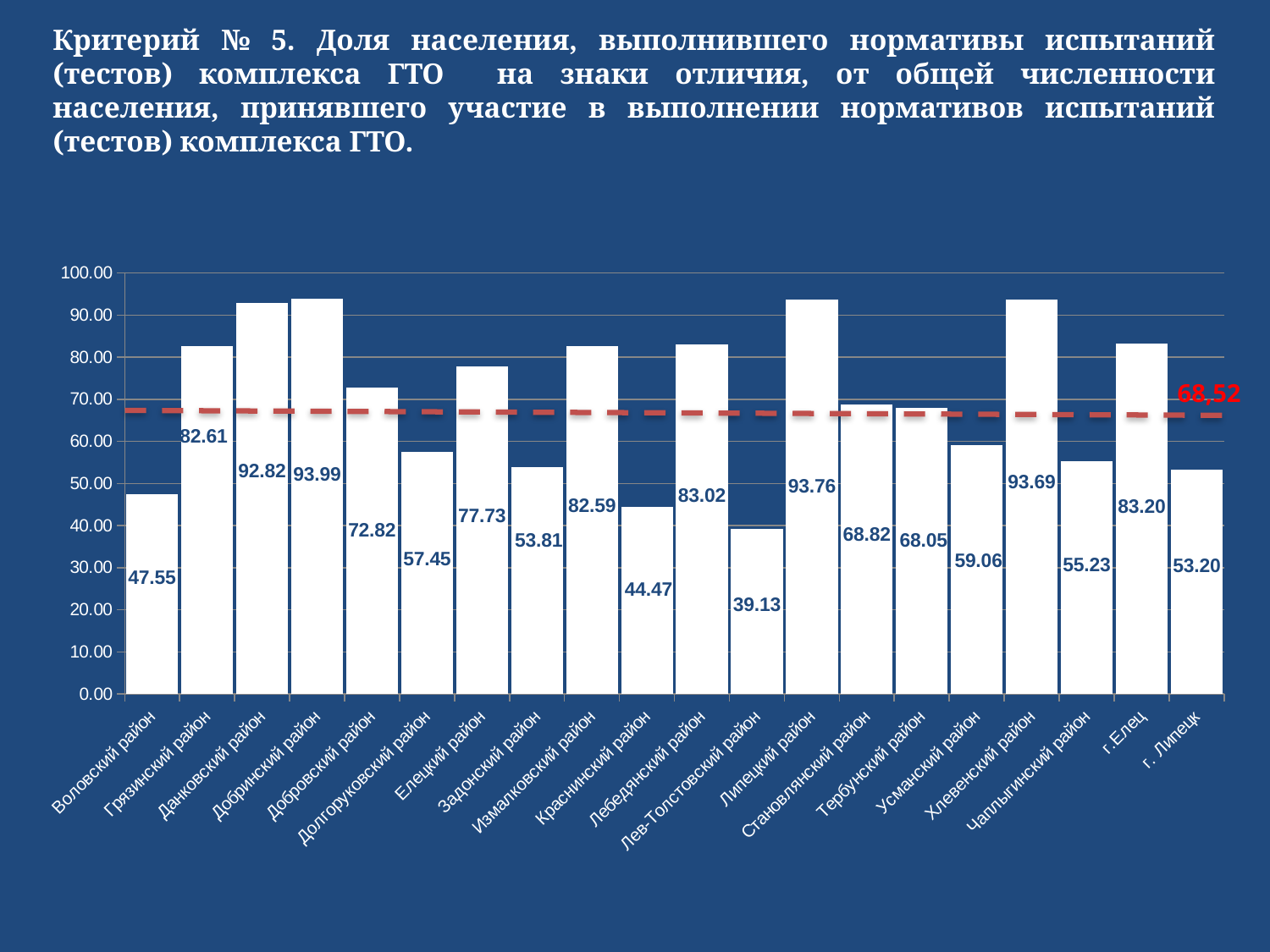
What kind of chart is shown on the slide? bar chart What is the value for Лев-Толстовский район? 39.13 Is the value for Краснинский район greater or less than 50.00? less What is the value for Хлевенский район? 93.69 Which category has the highest value? Добринский район How many categories are shown on the x axis? 20 Which is larger, the value for Грязинский район or the value for Усманский район? Грязинский район What value is labelled on the red dashed horizontal line? 68,52 What is the value for г. Липецк? 53.20 What is the difference between the values for Данковский район and Добровский район? 20.00 What is the value for Воловский район? 47.55 Which category has the lowest value? Лев-Толстовский район